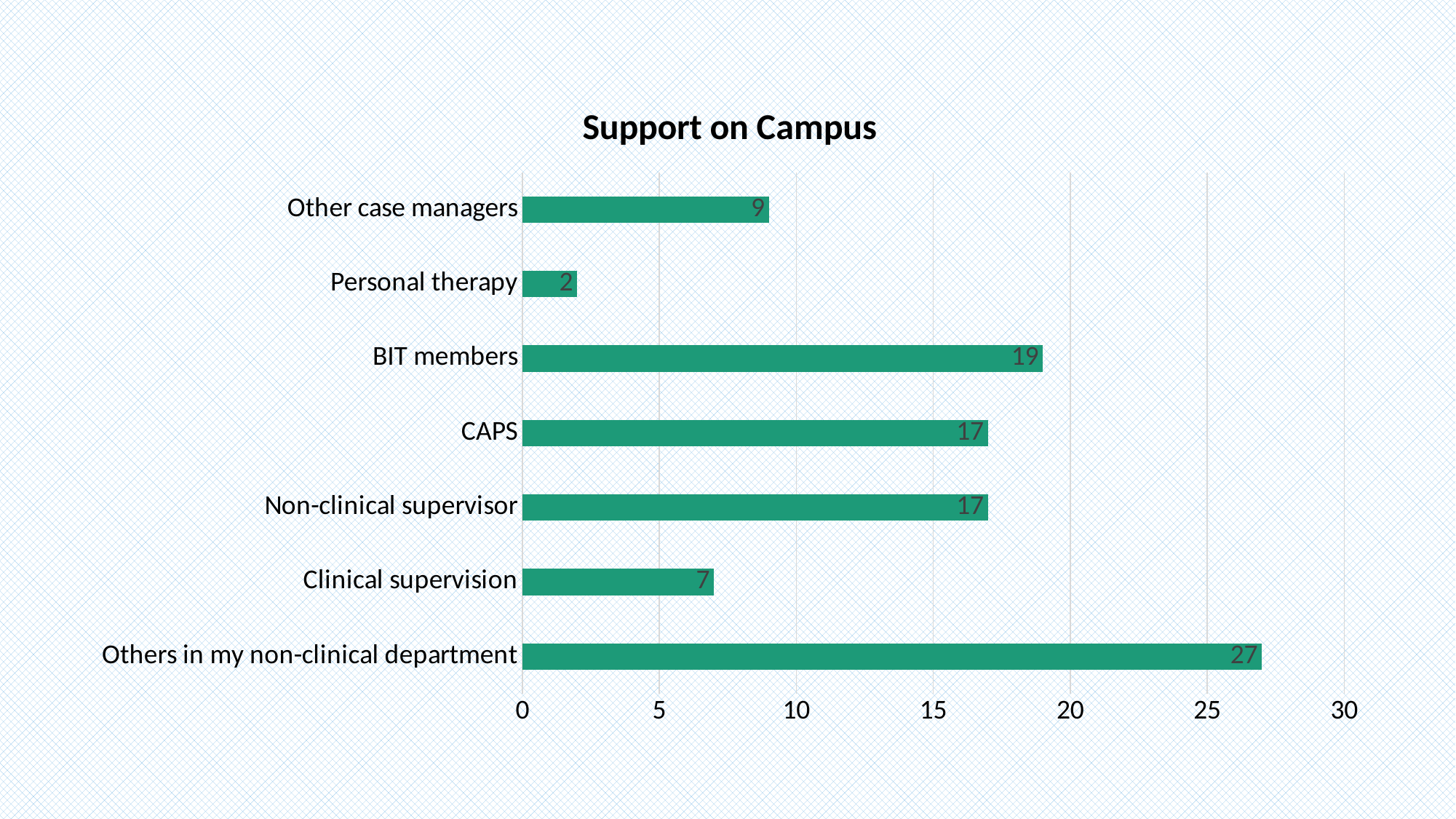
What is the difference between the values for Other case managers and Clinical supervision? 2 Which category has the lowest value? Personal therapy Is the value for Non-clinical supervisor greater or less than 15? greater What is the value for Clinical supervision? 7 What is the value for BIT members? 19 What is the difference between the values for Others in my non-clinical department and BIT members? 8 Which category has the highest value? Others in my non-clinical department What is the value for Personal therapy? 2 Which is larger, the value for CAPS or the value for Other case managers? CAPS What is the value for Others in my non-clinical department? 27 What kind of chart is this? Bar chart How many categories are shown in the chart? 7